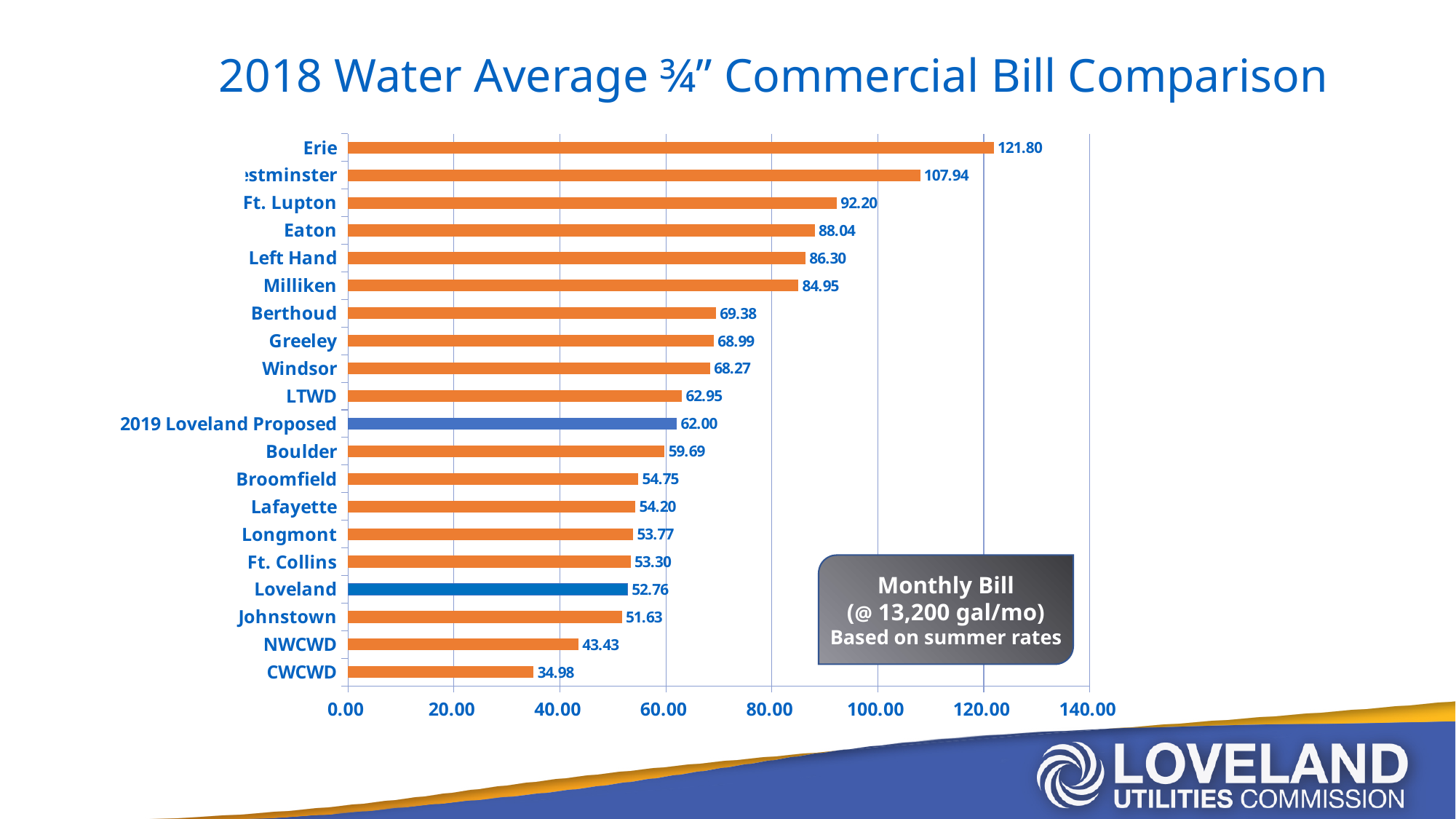
Which category has the lowest value? CWCWD Is the value for Milliken greater or less than 80.00? greater What kind of chart is shown on the slide? Bar chart What is the value for CWCWD? 34.98 What is the difference between the values for 2019 Loveland Proposed and Loveland? 9.24 What is the value for Erie? 121.80 What is the value for Loveland? 52.76 What is the title of the chart? 2018 Water Average ¾" Commercial Bill Comparison How many categories are shown in the chart? 20 Which is larger, the value for Ft. Lupton or the value for Eaton? Ft. Lupton What is the value for 2019 Loveland Proposed? 62.00 Which category has the highest value? Erie